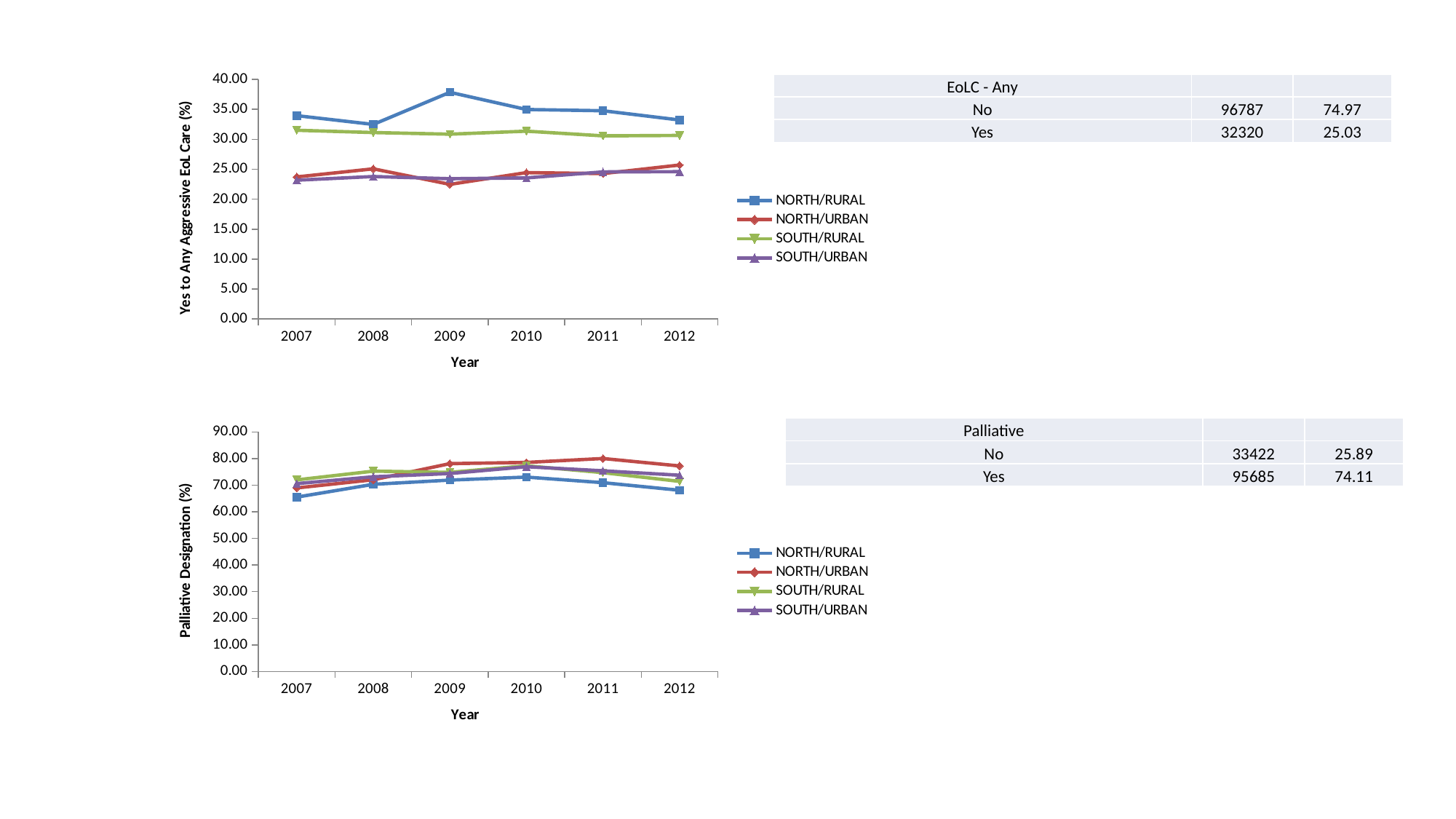
How many series does the legend of the top chart list? 4 In the bottom chart, is the value for NORTH/RURAL in 2007 greater or less than 70.00? less How many years are plotted along the x axis of the top chart? 6 In the top chart, which is larger in 2007: NORTH/RURAL or SOUTH/RURAL? NORTH/RURAL What kind of chart is the top chart (Yes to Any Aggressive EoL Care)? line chart In the top chart, is the value for NORTH/RURAL in 2009 greater or less than 35.00? greater In the top chart, in which year does the NORTH/RURAL series reach its highest value? 2009 In the bottom chart (Palliative Designation), which series has the highest value in 2011? NORTH/URBAN What is the y-axis label of the bottom chart? Palliative Designation (%) In the bottom chart, does the NORTH/URBAN series rise or fall from 2007 to 2011? rise In the top chart, which series has the highest value in 2009? NORTH/RURAL In the top chart, is the value for NORTH/URBAN in 2009 greater or less than 25.00? less